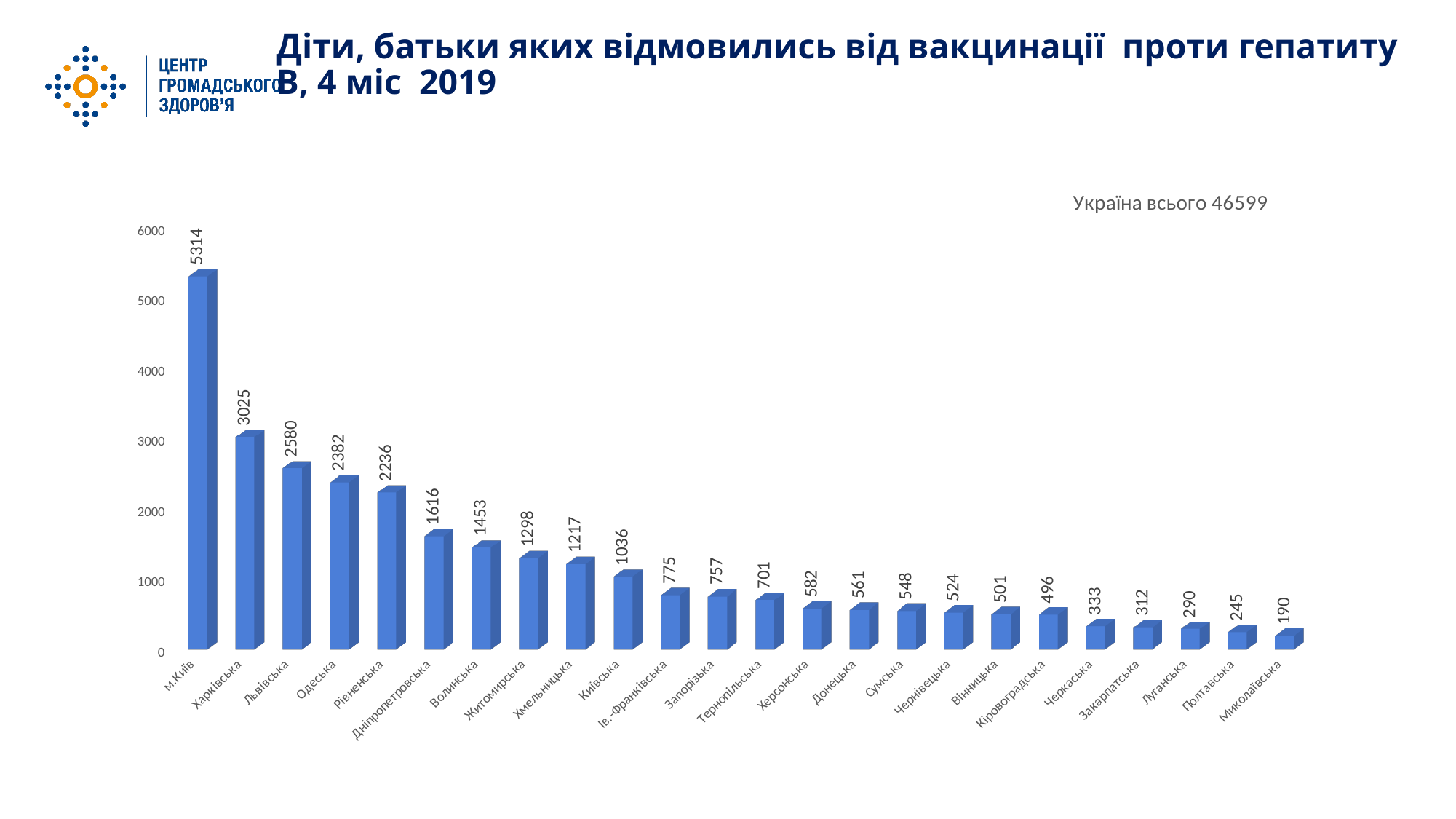
What is the difference between the values for Харківська and Львівська? 445 What kind of chart is shown on the slide? bar chart What total for Україна is printed above the chart? 46599 Which is larger, the value for Одеська or the value for Рівненська? Одеська What is the value for Херсонська? 582 What is the value for Дніпропетровська? 1616 Is the value for Волинська greater or less than 1000? greater Do the values rise or fall from left to right along the x axis? fall What is the value for м.Київ? 5314 How many categories are shown on the x axis? 24 Which category has the lowest value? Миколаївська Which category has the highest value? м.Київ